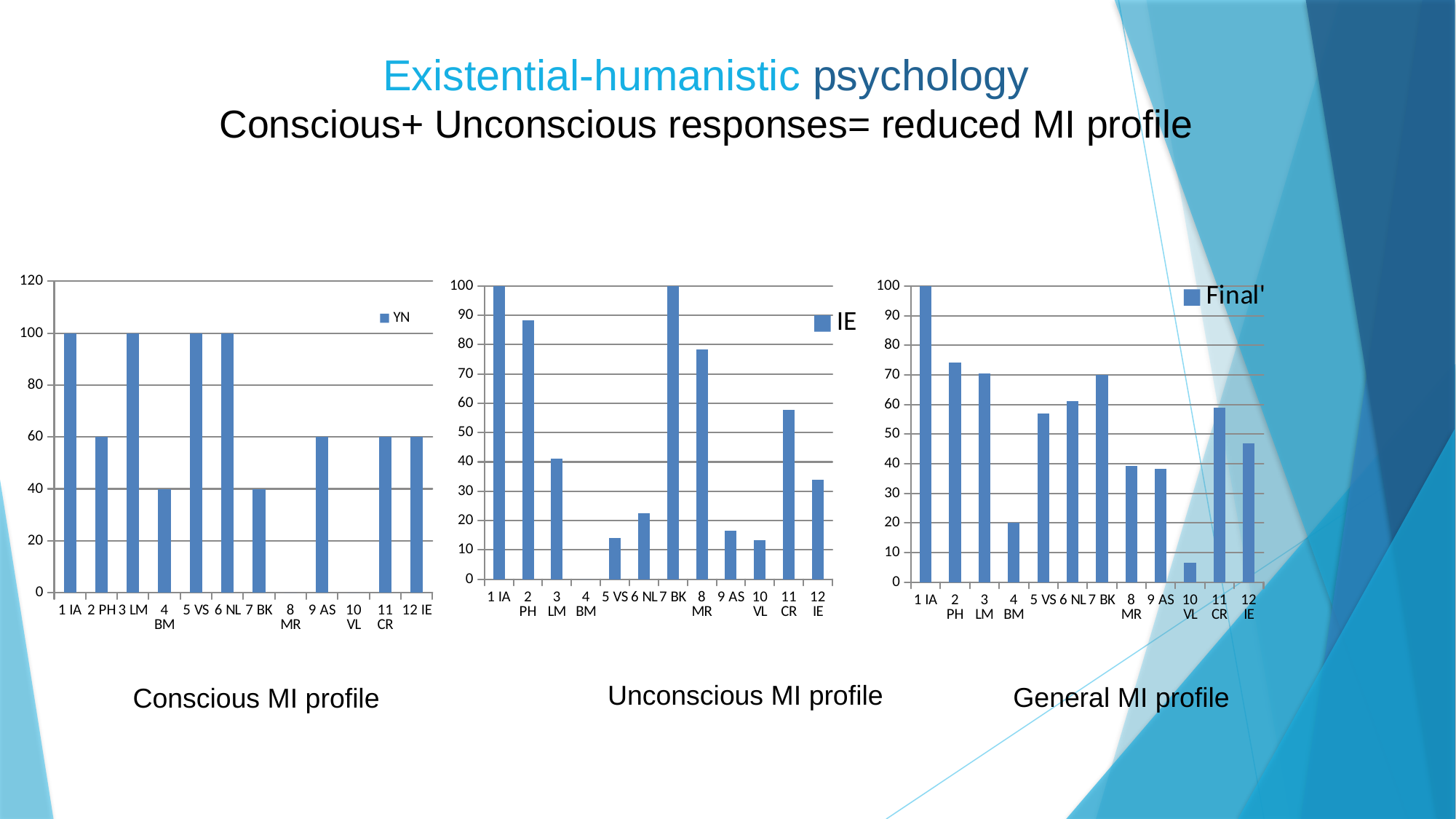
In the General MI profile chart, which is larger, the value for 2 PH or the value for 8 MR? 2 PH In the General MI profile chart, is the value for 10 VL greater or less than 10? less How many categories are shown on the x axis of the Conscious MI profile chart? 12 In the Conscious MI profile chart, what is the value for 4 BM? 40 In the Conscious MI profile chart, what is the value for 2 PH? 60 In the Unconscious MI profile chart, is the value for 5 VS greater or less than 20? less What series name does the legend of the Conscious MI profile chart show? YN In the Conscious MI profile chart, what is the difference between the values for 1 IA and 7 BK? 60 What type of chart is the General MI profile chart? bar chart What series name does the legend of the General MI profile chart show? Final' In the Unconscious MI profile chart, is the value for 2 PH greater or less than 80? greater